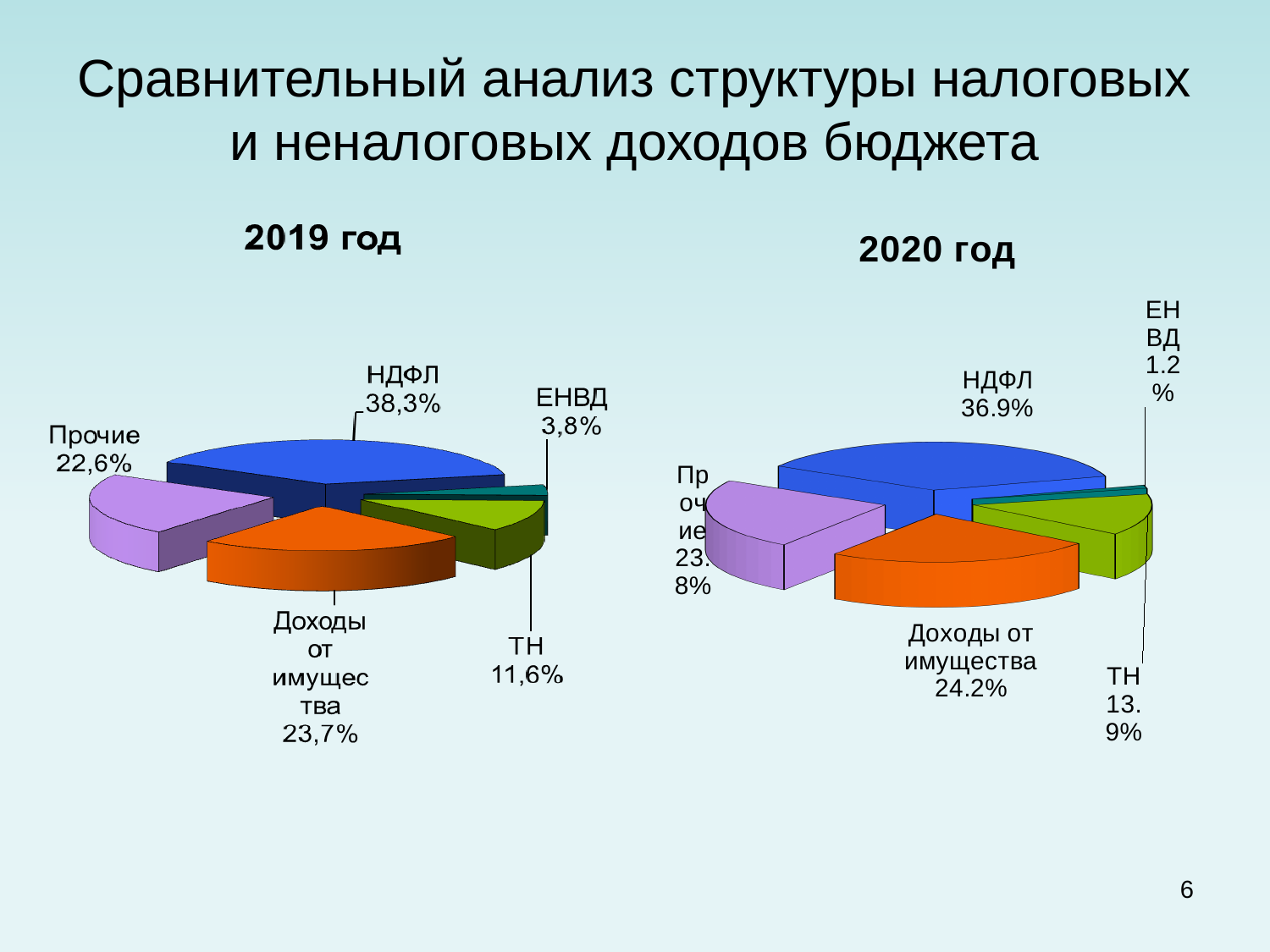
In the 2019 год chart, what is the difference between the shares of НДФЛ and ТН? 26,7% In the 2020 год chart, what is the share for ТН? 13.9% In the 2020 год chart, what is the share for НДФЛ? 36.9% In the 2019 год chart, what is the share for НДФЛ? 38,3% In the 2019 год chart, which category has the largest share? НДФЛ In the 2019 год chart, what is the share for ЕНВД? 3,8% What kind of chart is the 2019 год chart? pie chart In the 2019 год chart, which category has the smallest share? ЕНВД In the 2019 год chart, how many slices are there? 5 In the 2019 год chart, what is the share for Доходы от имущества? 23,7% In the 2020 год chart, which is larger, Доходы от имущества or ТН? Доходы от имущества In the 2020 год chart, what is the share for ЕНВД? 1.2%